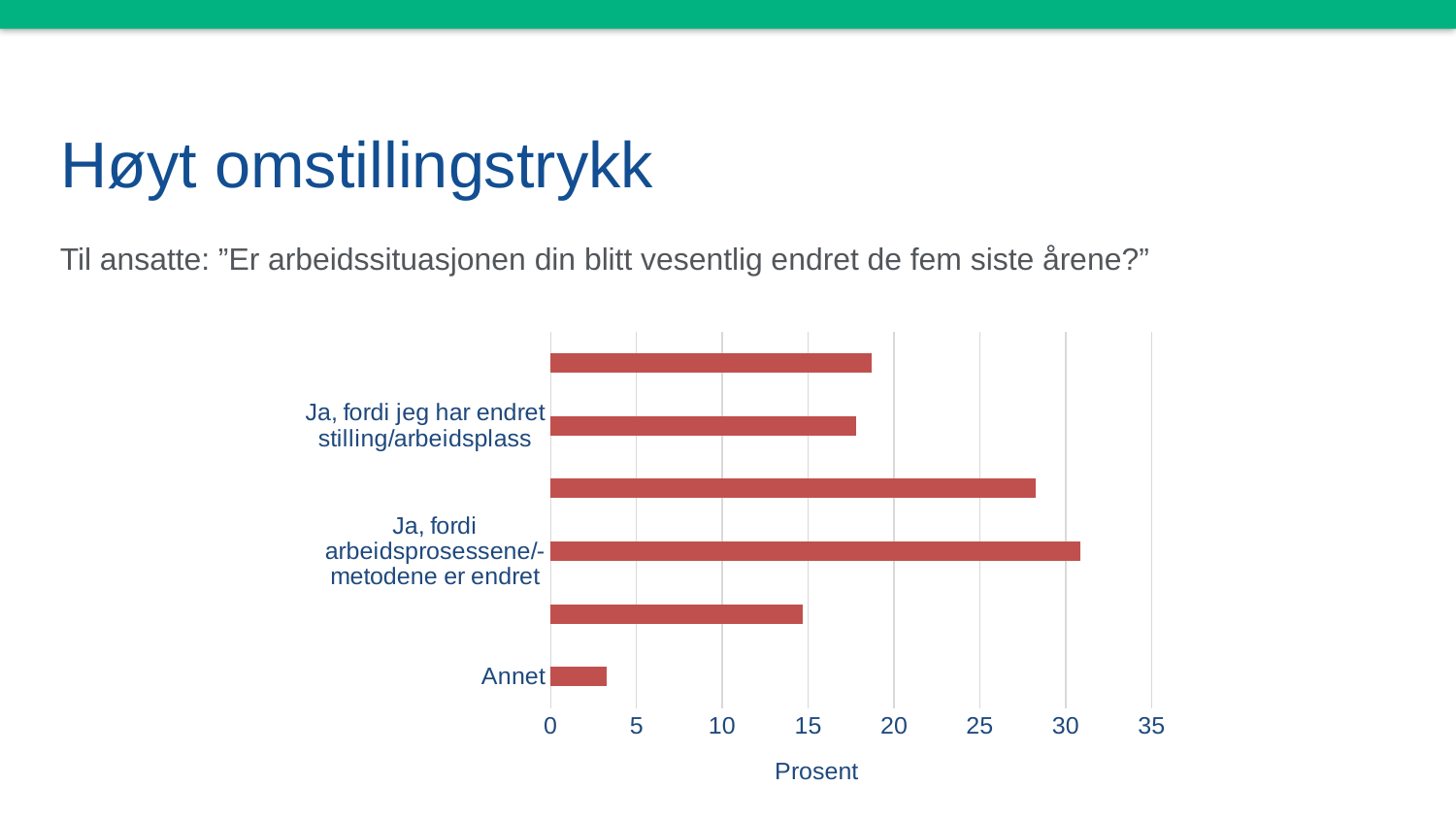
Is the value for Annet greater or less than 5? less Which is larger: the value for Annet or the value for "Ja, fordi jeg har endret stilling/arbeidsplass"? Ja, fordi jeg har endret stilling/arbeidsplass What is the title of the horizontal axis of the chart? Prosent What kind of chart is shown on the slide? Bar chart What is the highest value shown on the horizontal axis of the chart? 35 Is the value for "Ja, fordi arbeidsprosessene/-metodene er endret" greater or less than 25? greater How many bars are plotted in the chart? 6 Is the value for "Ja, fordi jeg har endret stilling/arbeidsplass" greater or less than 20? less Which is larger: the value for "Ja, fordi arbeidsprosessene/-metodene er endret" or the value for "Ja, fordi jeg har endret stilling/arbeidsplass"? Ja, fordi arbeidsprosessene/-metodene er endret Which labelled category has the highest value in the chart? Ja, fordi arbeidsprosessene/-metodene er endret Which labelled category has the lowest value in the chart? Annet